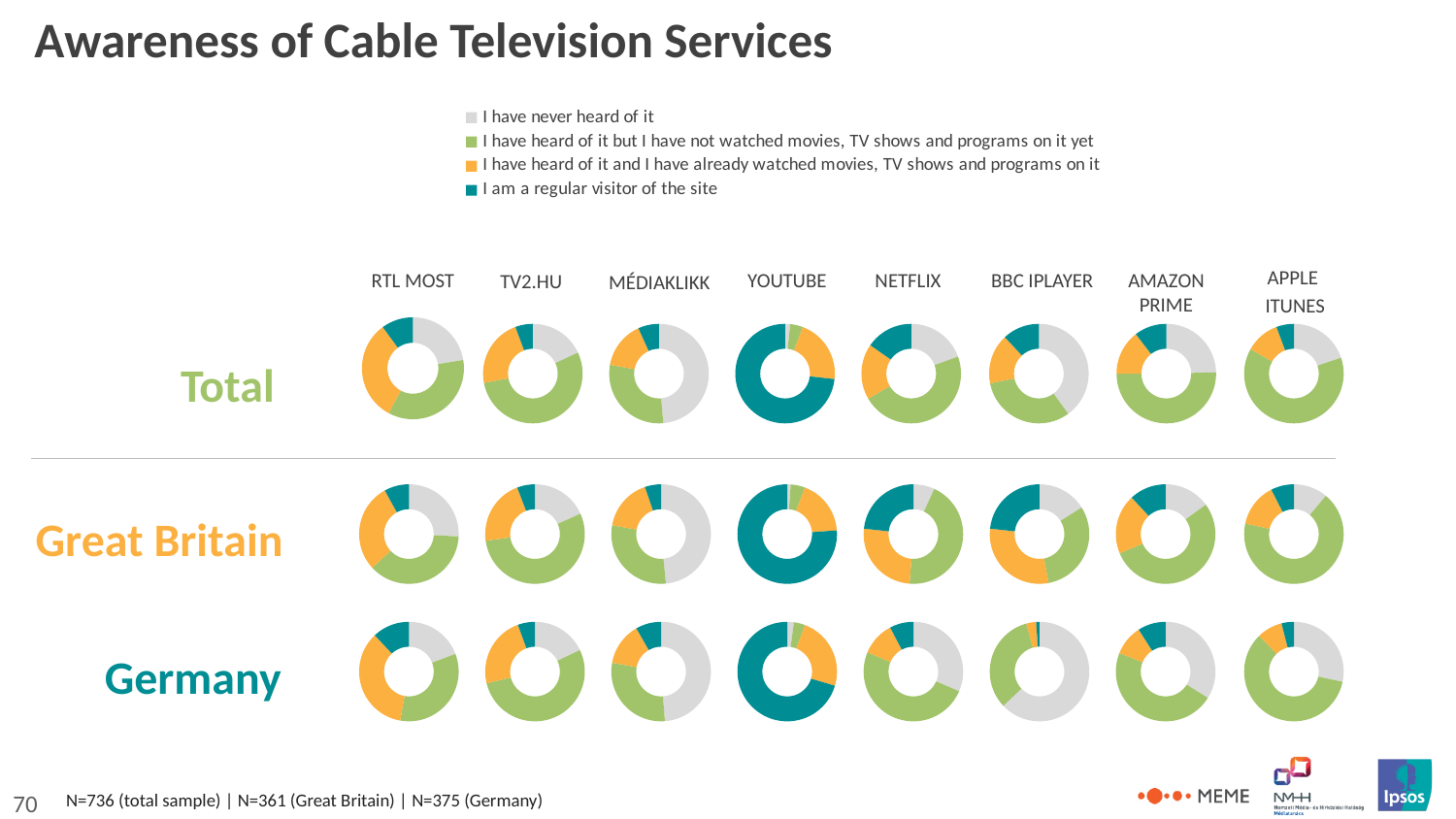
How many sample groups (rows of charts) are shown on the slide? 3 What kind of chart is used to show awareness of each service on this slide? pie chart (donut) In the Total row, which service has the largest share of respondents who are regular visitors of the site? YouTube What is the title of the slide? Awareness of Cable Television Services In the Total row, is the share of regular visitors larger for YouTube or for Netflix? YouTube How many response categories does the legend list? 4 For BBC iPlayer, is the share of regular visitors larger in Great Britain or in Germany? Great Britain In the Germany row, which service has the largest share of respondents who have never heard of it? BBC iPlayer In the Total row chart for YouTube, which response category takes up the largest share? I am a regular visitor of the site How many cable television services are shown in each row of charts? 8 Which legend entry is represented by the dark teal colour? I am a regular visitor of the site